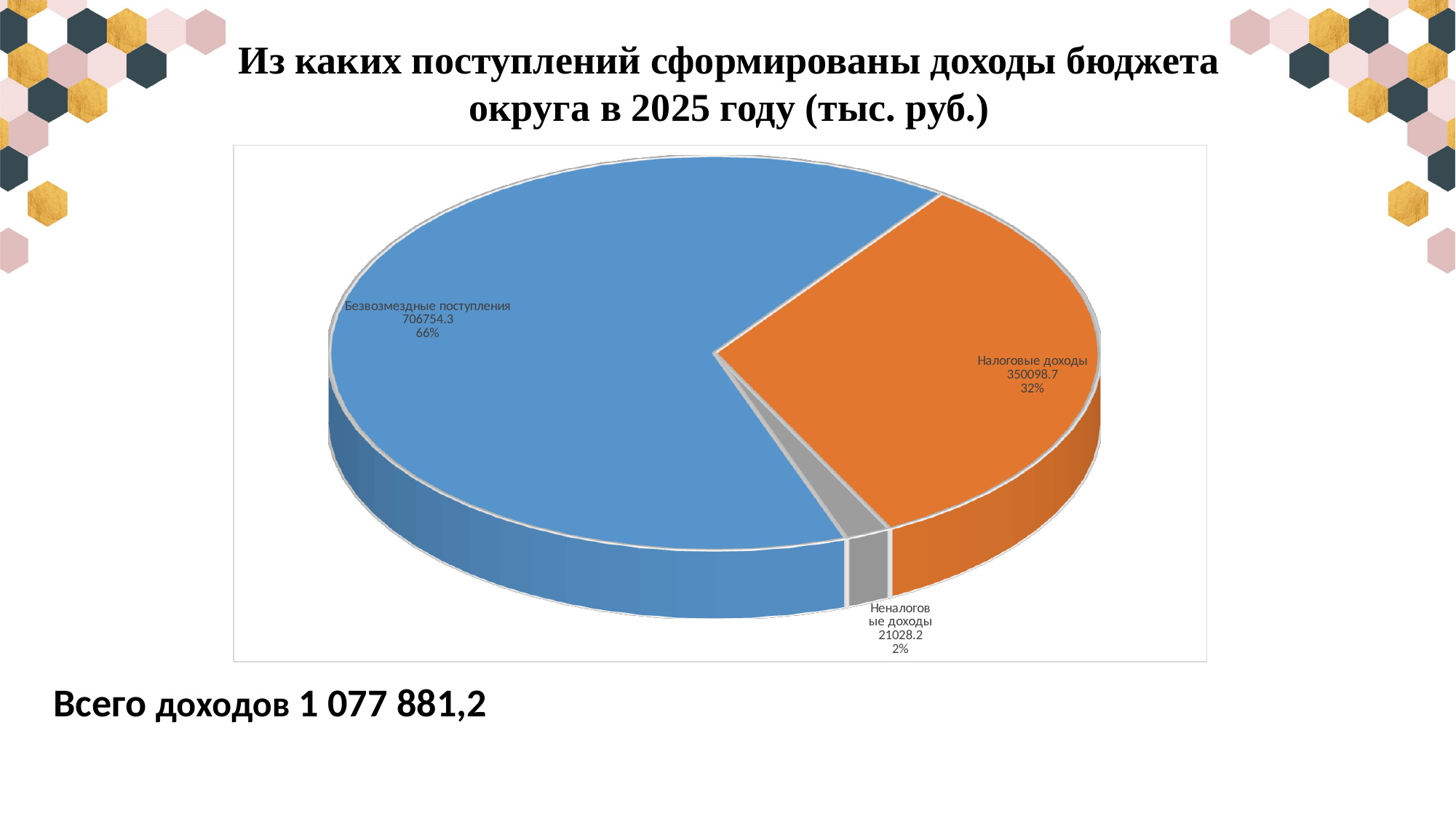
What share of the pie does Безвозмездные поступления represent? 66% What is the value for Неналоговые доходы? 21028.2 What kind of chart is shown on the slide? pie chart What is the value for Налоговые доходы? 350098.7 What share of the pie does Налоговые доходы represent? 32% What share of the pie does Неналоговые доходы represent? 2% How many slices does the pie chart have? 3 Which is larger, Налоговые доходы or Неналоговые доходы? Налоговые доходы What colour is the slice for Налоговые доходы? orange What is the value for Безвозмездные поступления? 706754.3 Which category has the largest slice? Безвозмездные поступления Which category has the smallest slice? Неналоговые доходы